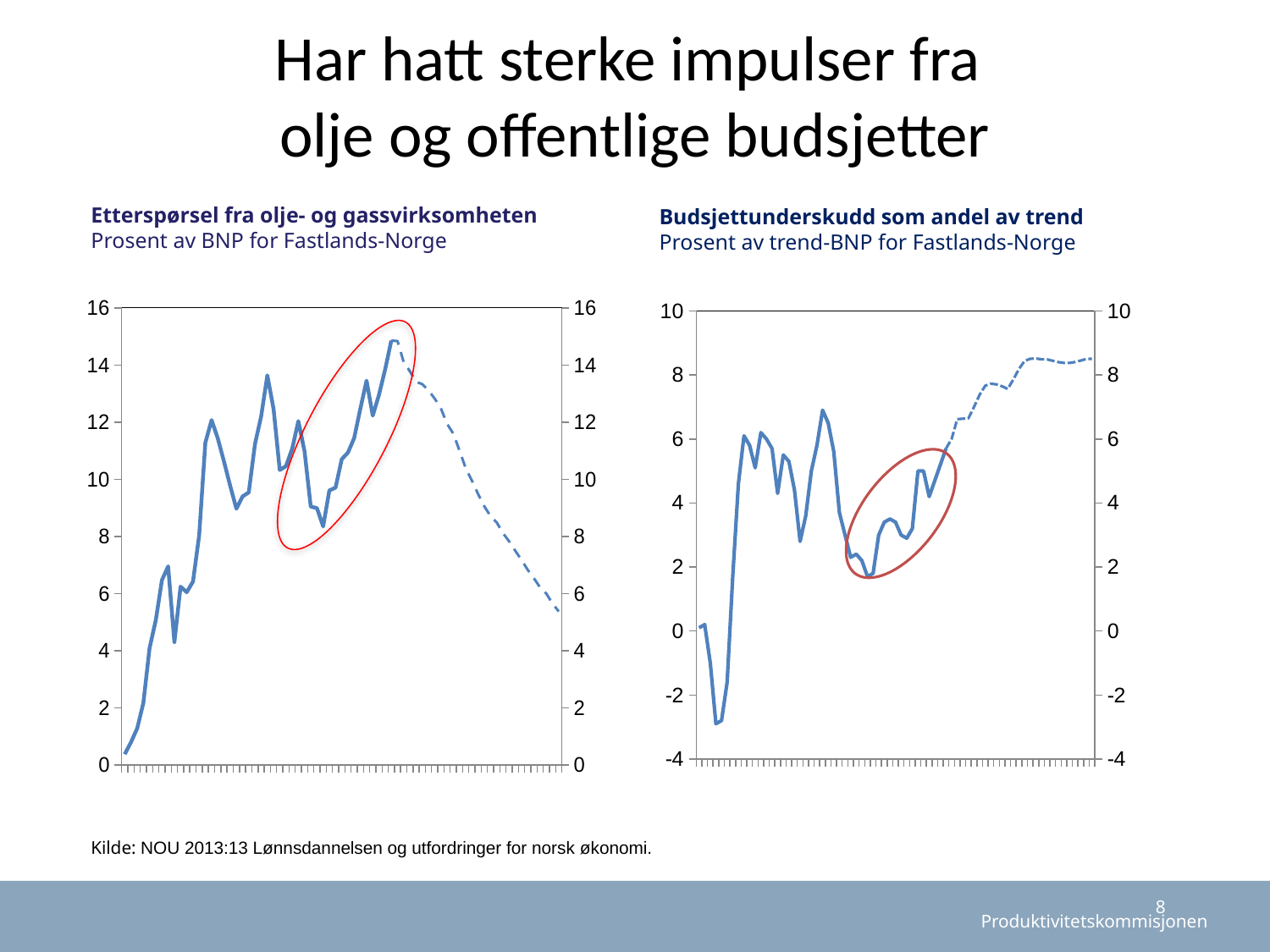
What kind of chart is the left chart titled 'Etterspørsel fra olje- og gassvirksomheten'? line chart In the left chart, is the highest value reached by the solid line greater or less than 14? greater In the right chart, is the value at the start of the solid line greater or less than 2? less What kind of chart is the right chart titled 'Budsjettunderskudd som andel av trend'? line chart In the right chart, does the dashed line at the right end rise or fall overall along the x axis? rise In the right chart, is the lowest value reached by the solid line greater or less than -2? less What is the minimum value shown on the vertical axis of the right chart? -4 What is the maximum value shown on the vertical axis of the left chart? 16 In the left chart, does the dashed line at the right end rise or fall along the x axis? fall